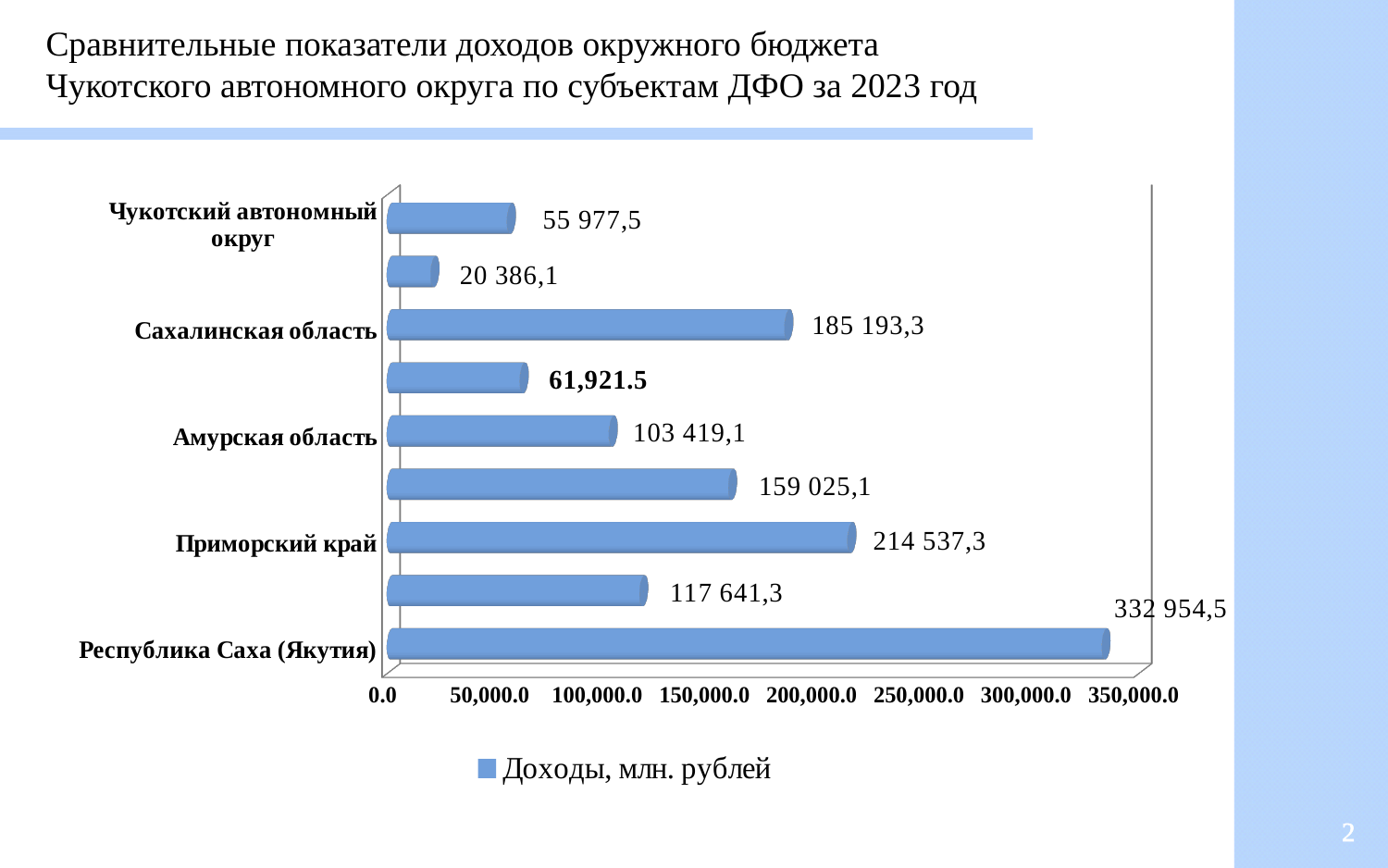
What is the value for Республика Саха (Якутия)? 332 954,5 What is the value for Сахалинская область? 185 193,3 What is the value for Чукотский автономный округ? 55 977,5 How many bars are plotted on the chart? 9 Which labelled region has the highest value? Республика Саха (Якутия) What is the value for Приморский край? 214 537,3 What kind of chart is shown on the slide? bar chart Which is larger, the value for Амурская область or the value for Сахалинская область? Сахалинская область How many series does the legend list? 1 Is the value for Амурская область greater or less than 100,000.0? greater What is the smallest value shown on the chart? 20 386,1 What is the difference between the values for Приморский край and Сахалинская область? 29 344,0